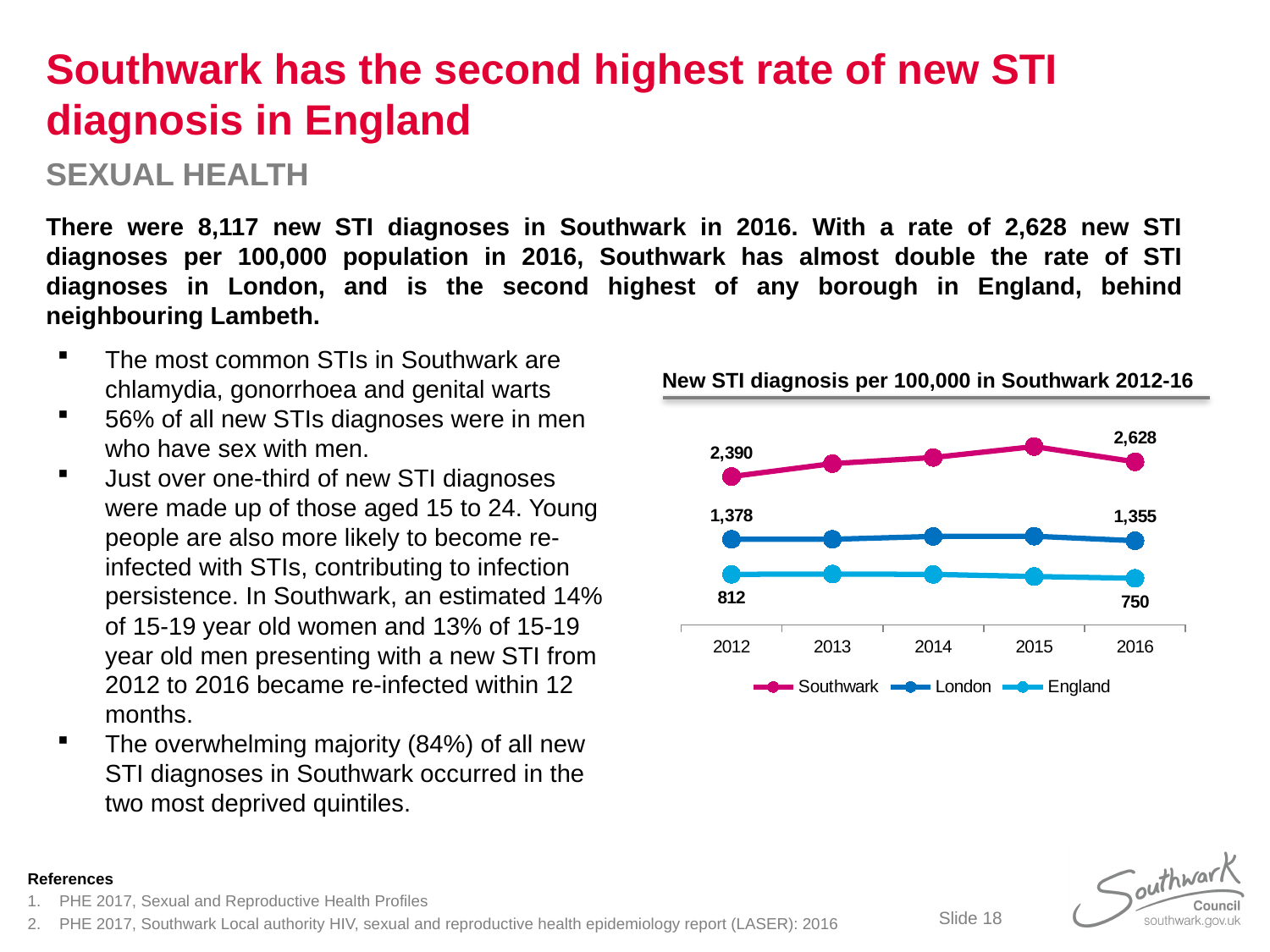
By how much did the Southwark value change from 2012 to 2016? 238 What type of chart is shown on the slide? Line chart What is the difference between the Southwark and London values in 2016? 1,273 What was the Southwark value in 2012? 2,390 Which series has the lowest values across all years? England What was the England value in 2016? 750 How many years are plotted on the x axis of the chart? 5 What is the title of the chart? New STI diagnosis per 100,000 in Southwark 2012-16 How many series does the chart legend list? 3 Did the England value rise or fall between 2012 and 2016? Fall What was the London value in 2012? 1,378 What was the Southwark value in 2016? 2,628